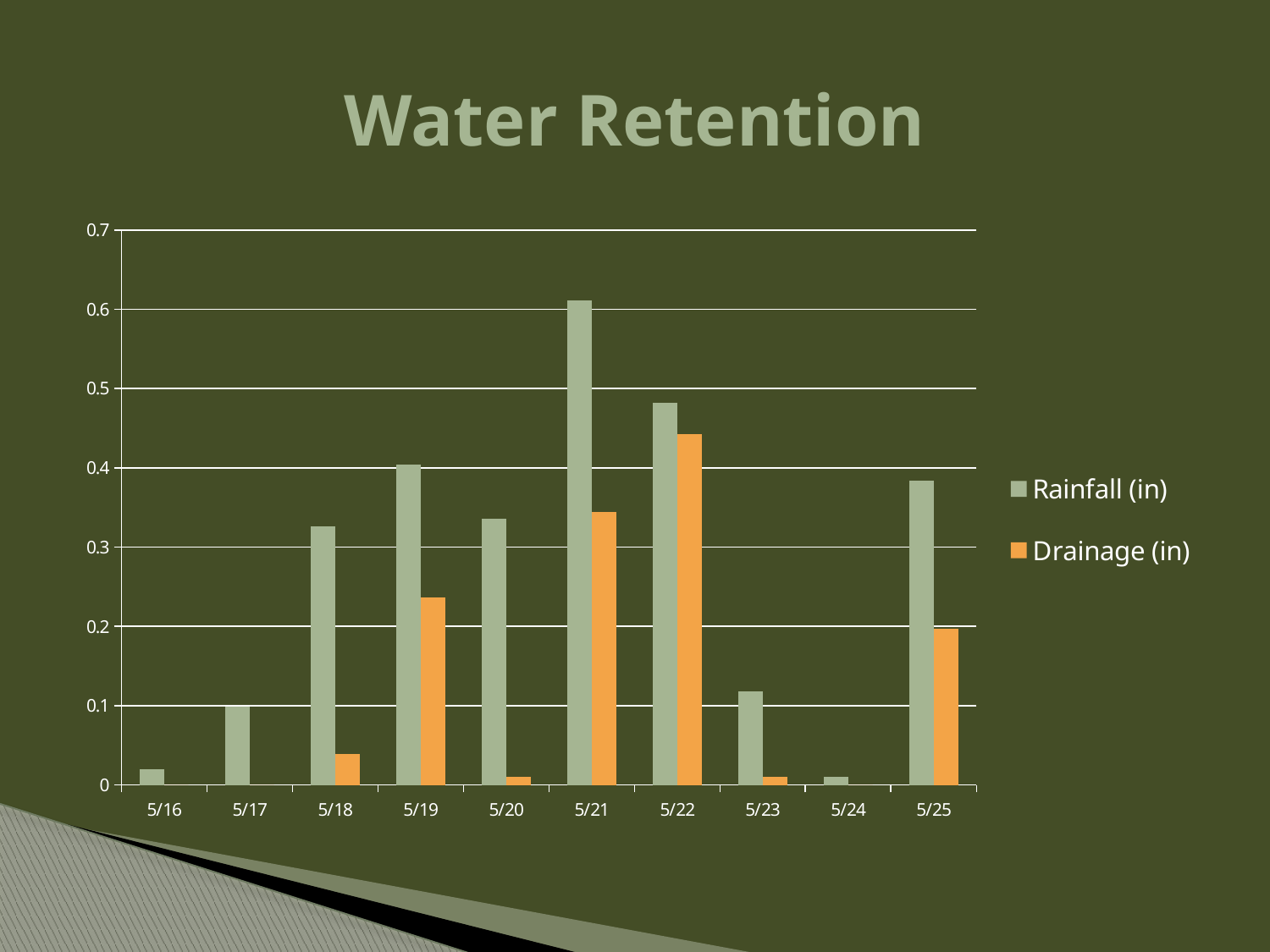
On which date is Rainfall (in) highest? 5/21 Is the Drainage (in) value for 5/19 greater or less than 0.3? less Which series is shown in orange? Drainage (in) What is the title of the chart? Water Retention Which is larger, Rainfall (in) on 5/19 or Rainfall (in) on 5/23? 5/19 How many dates are shown on the x axis? 10 What type of chart is shown on the slide? bar chart Is the Rainfall (in) value for 5/21 greater or less than 0.6? greater Is the Rainfall (in) value for 5/22 greater or less than 0.5? less Which is larger on 5/25, Rainfall (in) or Drainage (in)? Rainfall (in) How many series does the legend list? 2 On which date is Drainage (in) highest? 5/22